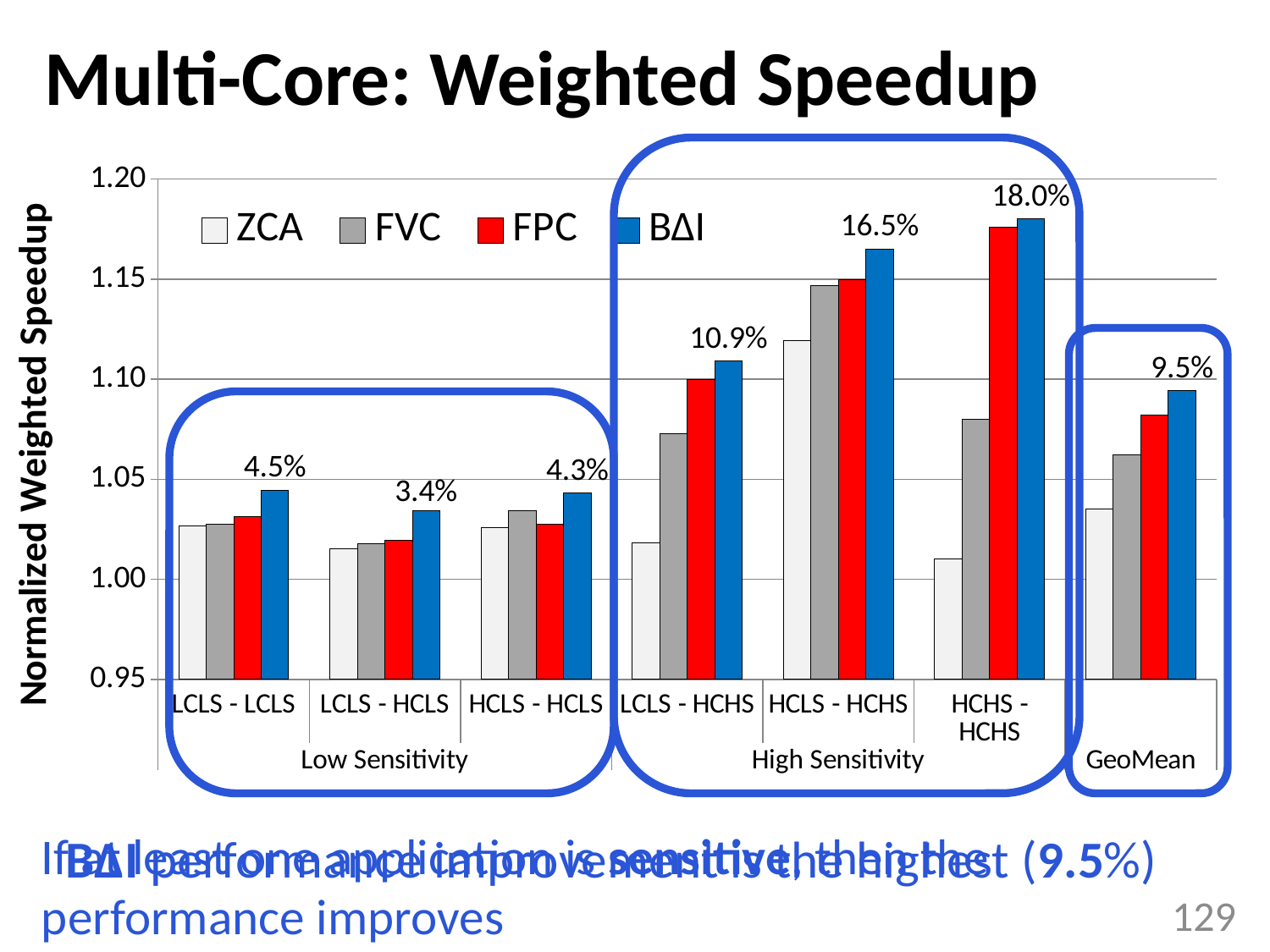
Which category has the highest BΔI bar? HCHS - HCHS How many workload categories are shown along the x axis? 7 Which category has the lowest BΔI bar? LCLS - HCLS What is the title of the y axis? Normalized Weighted Speedup How many series does the legend list? 4 Is the value of the FVC bar for HCHS - HCHS greater or less than 1.10? less What percentage label is shown above the BΔI bar for GeoMean? 9.5% What is the difference between the percentage labels for HCHS - HCHS and HCLS - HCHS? 1.5% For HCHS - HCHS, which is larger, the FPC bar or the FVC bar? FPC What percentage label is shown above the BΔI bar for HCHS - HCHS? 18.0% What kind of chart is shown on the slide? bar chart What percentage label is shown above the BΔI bar for LCLS - HCHS? 10.9%